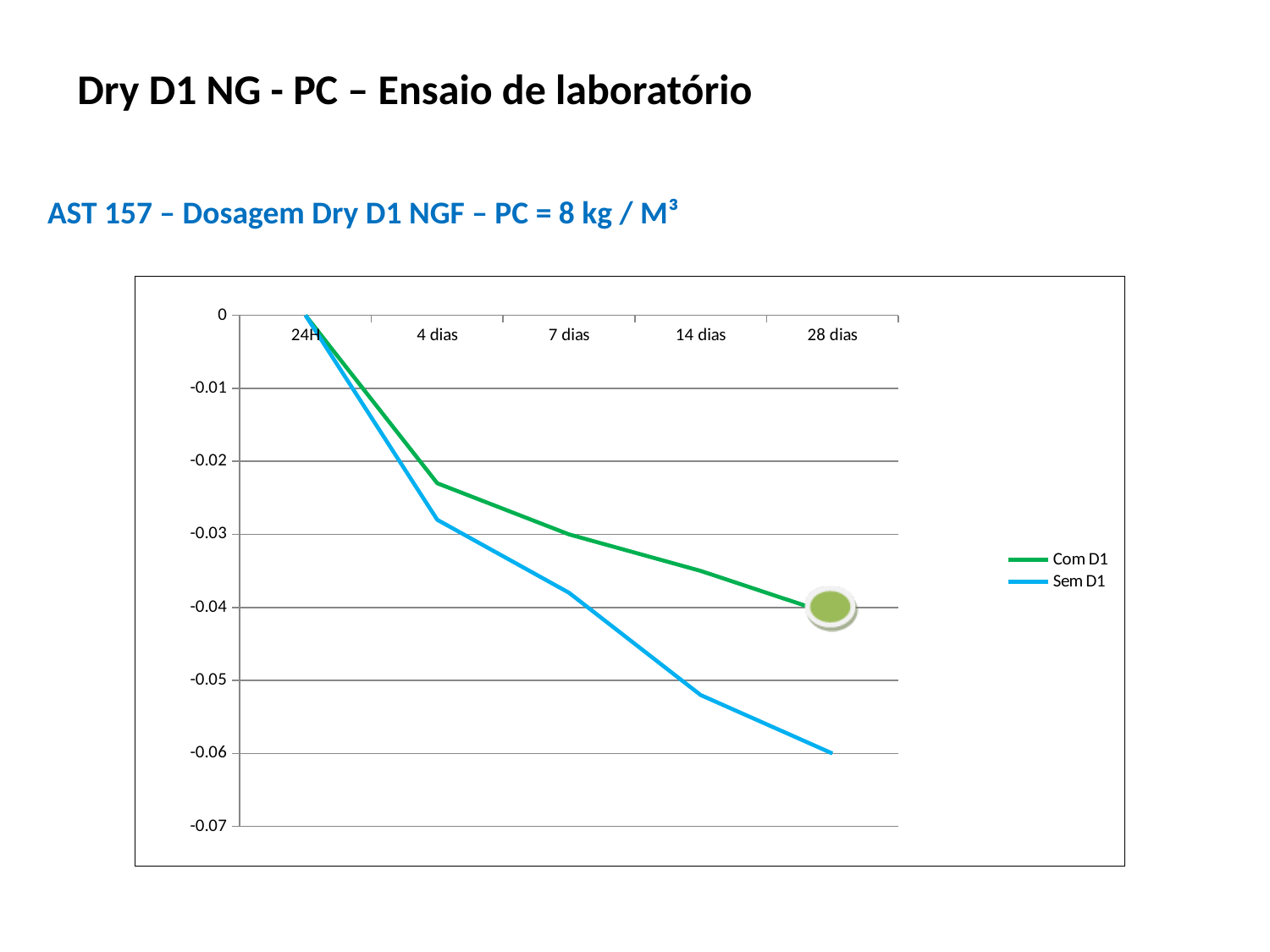
What is the value for Sem D1 at 28 dias? -0.06 Is the value for Sem D1 at 14 dias greater or less than -0.05? less Do the values for Sem D1 rise or fall from 24H to 28 dias? fall Which series reaches the lowest value at 28 dias? Sem D1 How many series does the legend list? 2 At 14 dias, which series has the higher (less negative) value, Com D1 or Sem D1? Com D1 What is the value for Com D1 at 24H? 0 Is the value for Com D1 at 4 dias greater or less than -0.02? less What kind of chart is shown on the slide? line chart How many time points are shown on the x axis? 5